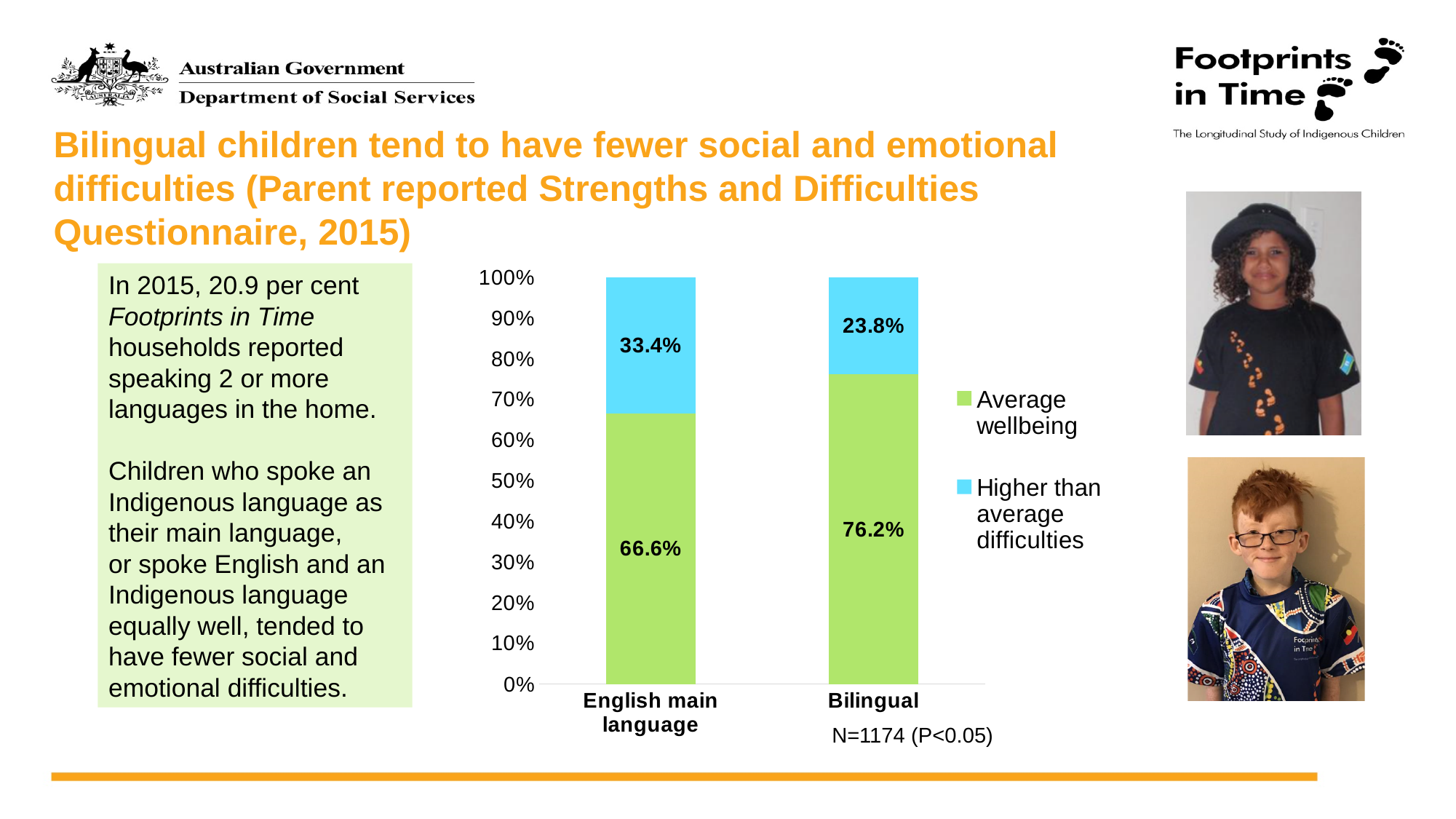
How many language groups are shown on the x axis? 2 What percentage of bilingual children have average wellbeing? 76.2% What percentage of bilingual children have higher than average difficulties? 23.8% Which group has the lower share of children with higher than average difficulties? Bilingual What is the difference in the share of higher than average difficulties between English main language and Bilingual children? 9.6% Which group has the higher share of children with average wellbeing? Bilingual What percentage of children with English as main language have higher than average difficulties? 33.4% How many series does the legend list? 2 Is the share of average wellbeing larger for English main language or Bilingual children? Bilingual What kind of chart is shown on the slide? Stacked bar chart What is the total of the stacked bar for Bilingual children? 100% What percentage of children with English as main language have average wellbeing? 66.6%